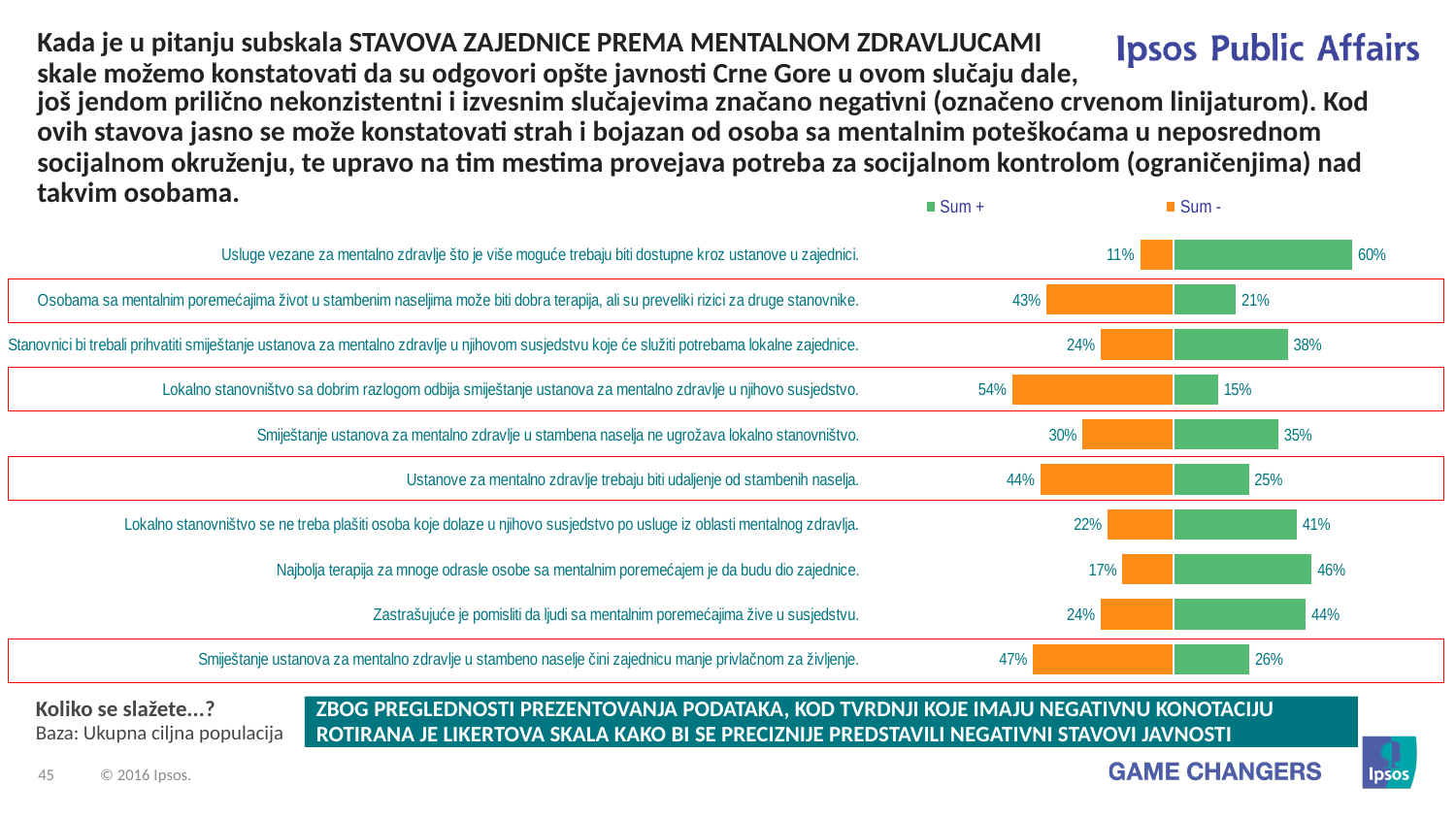
What is the difference between the Sum - and Sum + values for "Smiještanje ustanova za mentalno zdravlje u stambeno naselje čini zajednicu manje privlačnom za življenje."? 21% How many statements (categories) are plotted in the chart? 10 For "Smiještanje ustanova za mentalno zdravlje u stambena naselja ne ugrožava lokalno stanovništvo.", which is larger, Sum + or Sum -? Sum + Which statement has the lowest Sum - value? Usluge vezane za mentalno zdravlje što je više moguće trebaju biti dostupne kroz ustanove u zajednici. Which colour represents the Sum - series in the chart? orange What is the Sum - value for "Lokalno stanovništvo sa dobrim razlogom odbija smiještanje ustanova za mentalno zdravlje u njihovo susjedstvo."? 54% What is the total of Sum + and Sum - for "Ustanove za mentalno zdravlje trebaju biti udaljenje od stambenih naselja."? 69% How many series does the legend list? 2 What is the Sum + value for "Usluge vezane za mentalno zdravlje što je više moguće trebaju biti dostupne kroz ustanove u zajednici."? 60% What kind of chart is shown on the slide? bar chart Which statement has the highest Sum + value? Usluge vezane za mentalno zdravlje što je više moguće trebaju biti dostupne kroz ustanove u zajednici. What is the Sum + value for "Najbolja terapija za mnoge odrasle osobe sa mentalnim poremećajem je da budu dio zajednice."? 46%